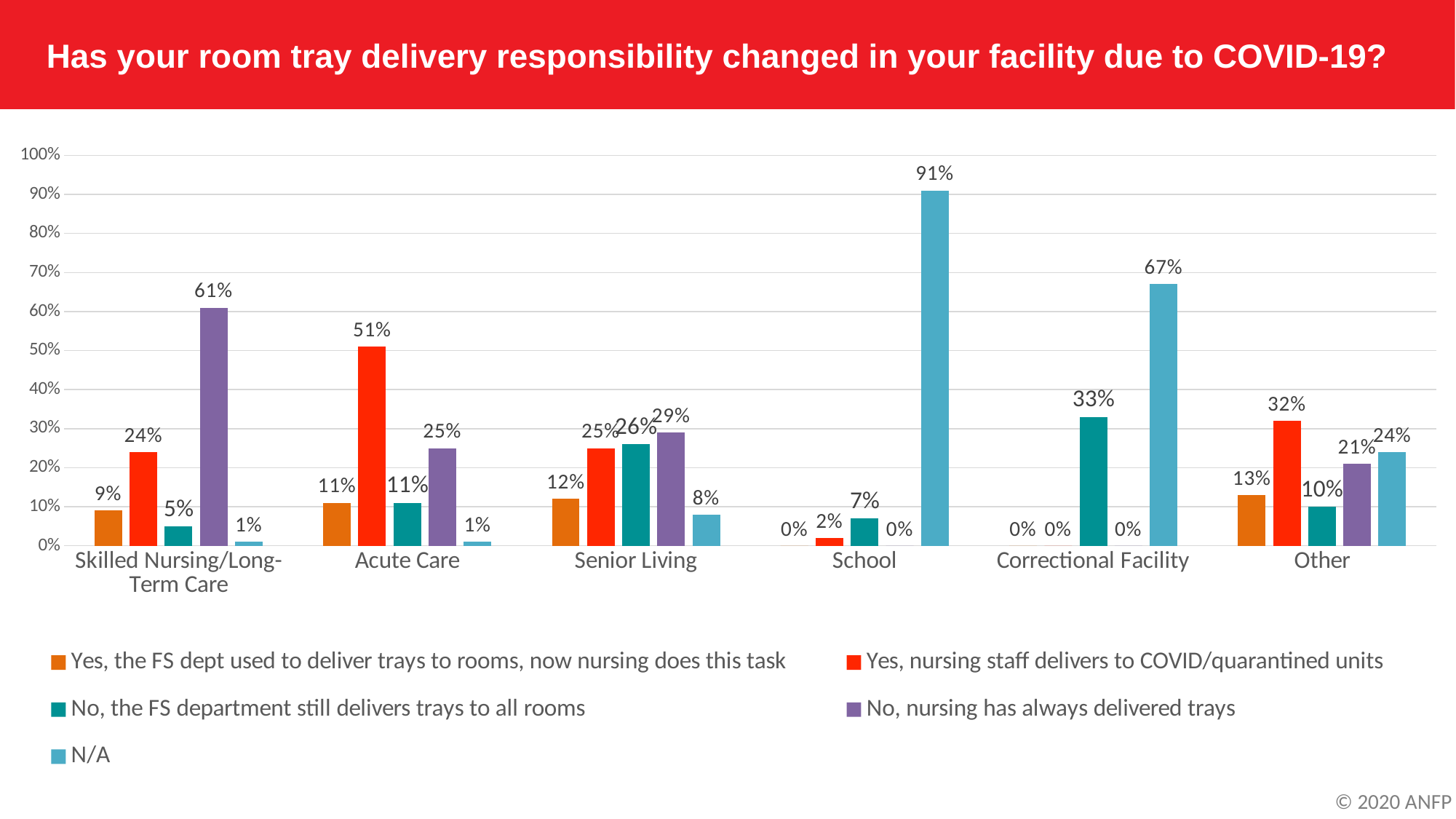
What kind of chart is shown on the slide? Bar chart Which is larger in Senior Living: "No, nursing has always delivered trays" or "Yes, the FS dept used to deliver trays to rooms, now nursing does this task"? No, nursing has always delivered trays What percentage of Skilled Nursing/Long-Term Care respondents answered "No, nursing has always delivered trays"? 61% What is the value for "Yes, nursing staff delivers to COVID/quarantined units" in Acute Care? 51% How many series does the legend list? 5 What is the difference between the "Yes, nursing staff delivers to COVID/quarantined units" values for Acute Care and Other? 19% What is the difference between the N/A values for School and Correctional Facility? 24% How many facility types are shown on the x axis? 6 What percentage of Correctional Facility respondents answered "No, the FS department still delivers trays to all rooms"? 33% Which facility type has the lowest value for "Yes, the FS dept used to deliver trays to rooms, now nursing does this task"? School and Correctional Facility (0%) What is the N/A value for School? 91% Which facility type has the highest N/A value? School